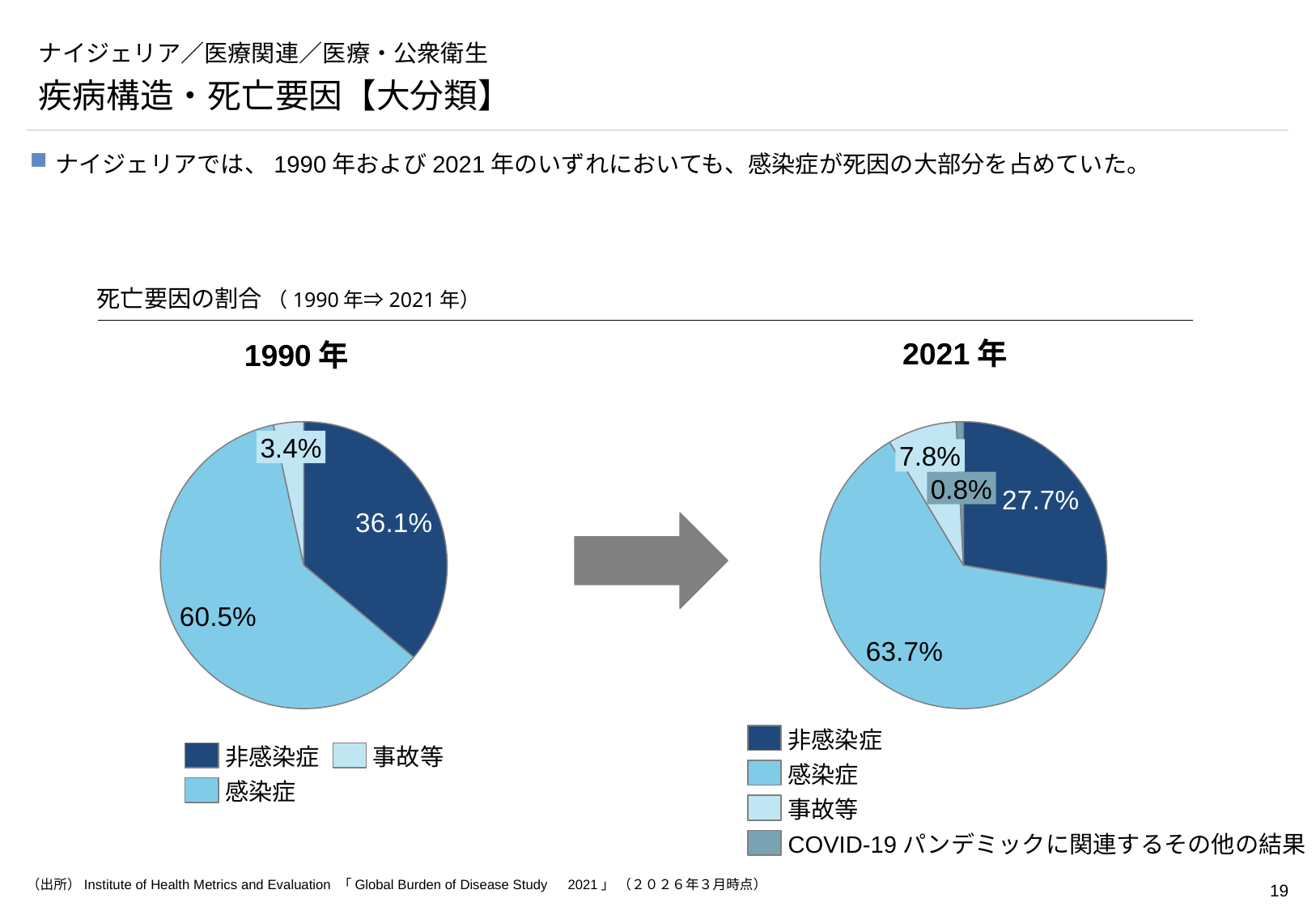
What is the difference between the 感染症 share in 2021年 and in 1990年? 3.2 percentage points In the 2021年 pie chart, which category has the largest share? 感染症 In the 1990年 pie chart, which category has the smallest share? 事故等 How many categories does the 2021年 pie chart show? 4 In the 2021年 pie chart, which category has the smallest share? COVID-19 パンデミックに関連するその他の結果 Which is larger: the 非感染症 share in 1990年 or in 2021年? 1990年 How many categories does the 1990年 pie chart show? 3 In the 2021年 pie chart, what share is labelled for 事故等? 7.8% In the 2021年 pie chart, what share is labelled for COVID-19 パンデミックに関連するその他の結果? 0.8% In the 1990年 pie chart, what share is labelled for 非感染症? 36.1% What type of chart is used to show the 死亡要因の割合 for 1990年 and 2021年? Pie chart In the 1990年 pie chart, what share is labelled for 感染症? 60.5%